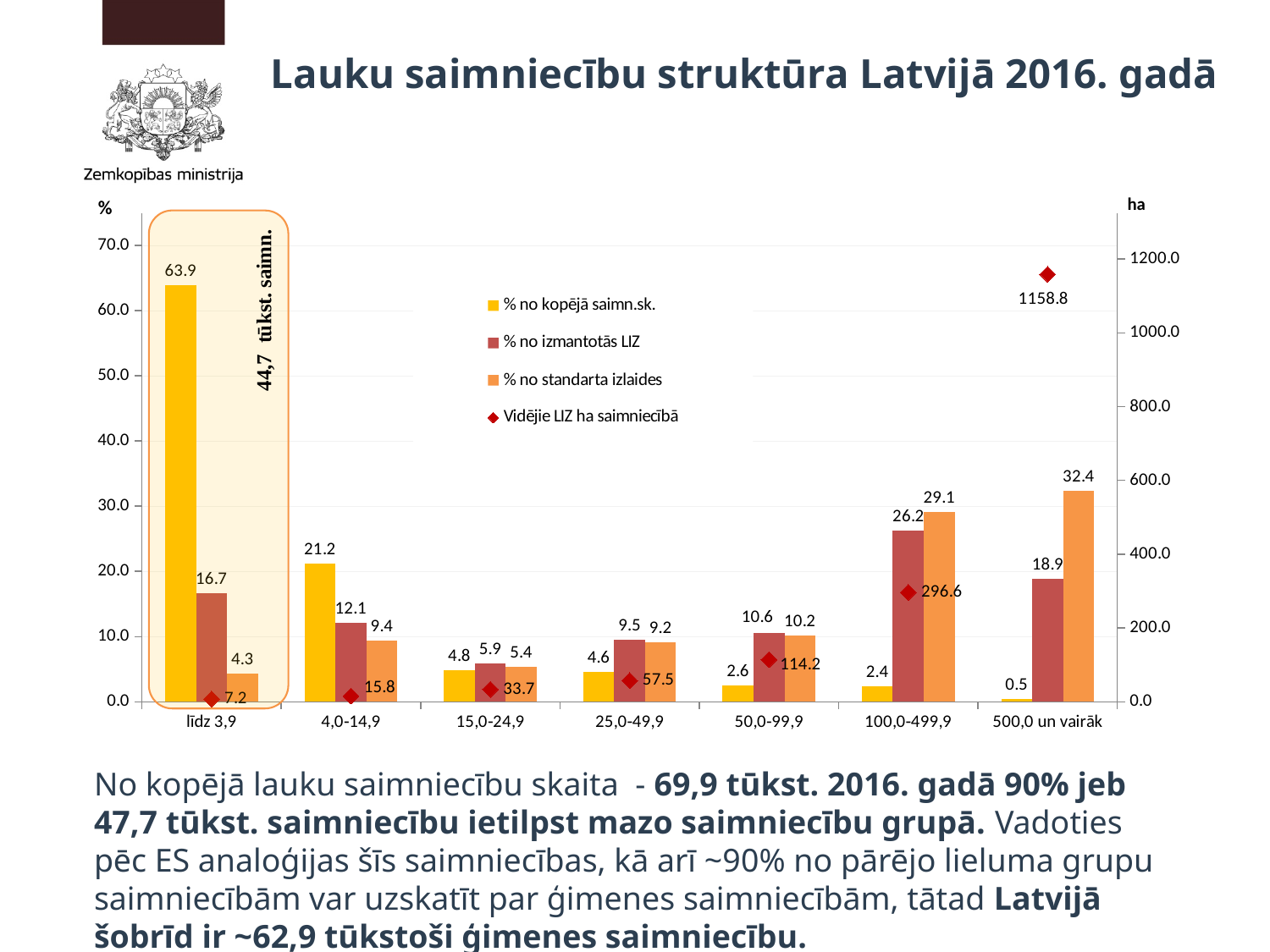
How many size categories are shown on the x axis? 7 Which category has the lowest value for "% no kopējā saimn.sk."? 500,0 un vairāk What is the value of "% no standarta izlaides" for the "100,0-499,9" category? 29.1 How many series does the legend list? 4 What is the title of the chart? Lauku saimniecību struktūra Latvijā 2016. gadā What is the value of "% no kopējā saimn.sk." for the "līdz 3,9" category? 63.9 What is the value of "Vidējie LIZ ha saimniecībā" for the "500,0 un vairāk" category? 1158.8 What kind of chart is shown on the slide? Bar chart with a marker series Which category has the highest value for "% no izmantotās LIZ"? 100,0-499,9 Which is larger: "% no standarta izlaides" for "500,0 un vairāk" or for "100,0-499,9"? 500,0 un vairāk Does the "Vidējie LIZ ha saimniecībā" series rise or fall from left to right along the x axis? Rise What is the difference between the "% no kopējā saimn.sk." values for "līdz 3,9" and "4,0-14,9"? 42.7